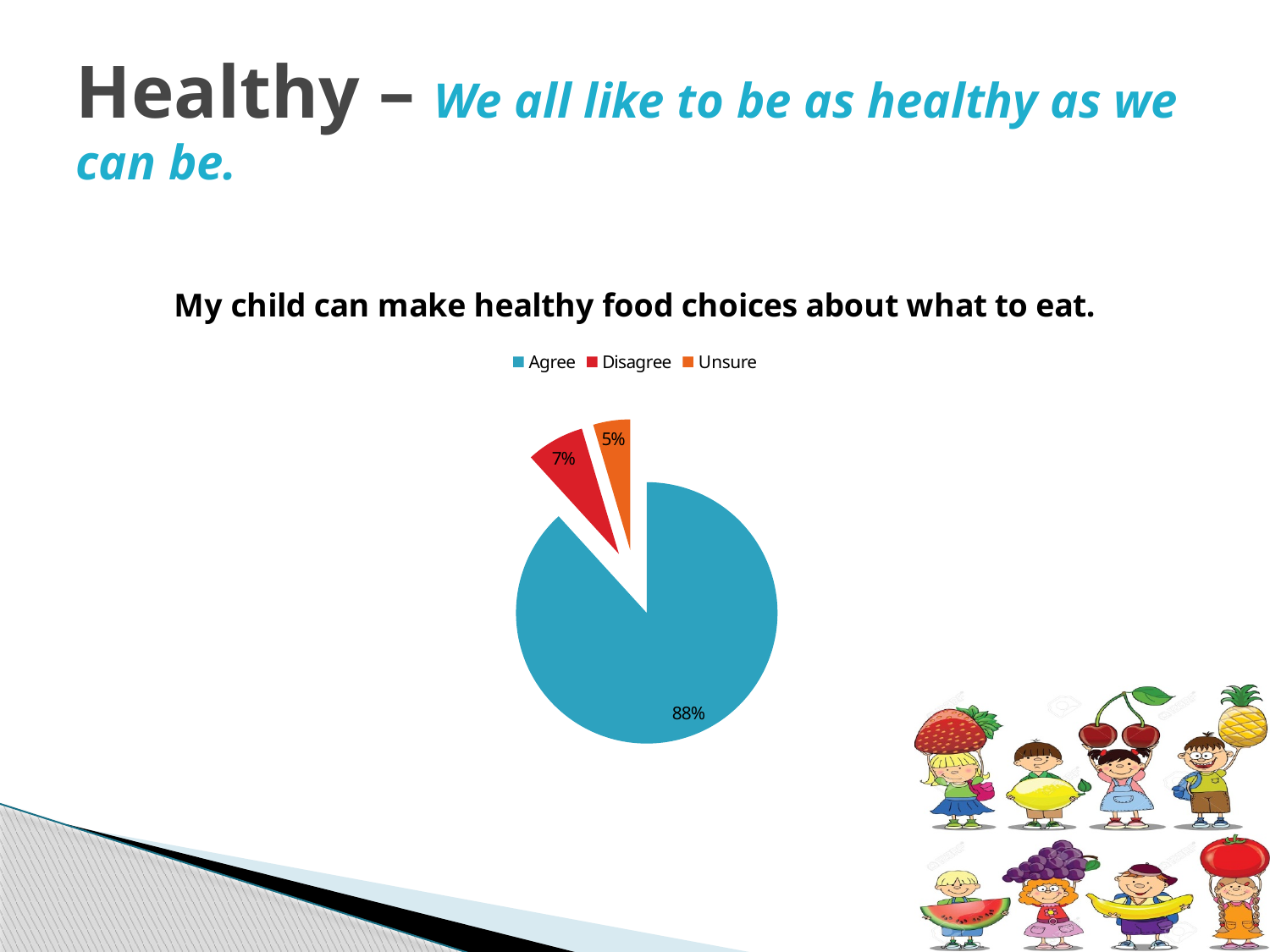
Which response has the largest share of the pie? Agree What percentage of respondents chose Disagree? 7% What colour is the Agree slice? blue What is the difference in percentage points between Disagree and Unsure? 2 What percentage of respondents chose Agree? 88% What is the difference in percentage points between Agree and Disagree? 81 What percentage of respondents chose Unsure? 5% How many categories does the legend list? 3 Which response has the smallest share of the pie? Unsure What is the chart's title? My child can make healthy food choices about what to eat. Which is larger, the share for Disagree or the share for Unsure? Disagree What kind of chart is shown on the slide? pie chart